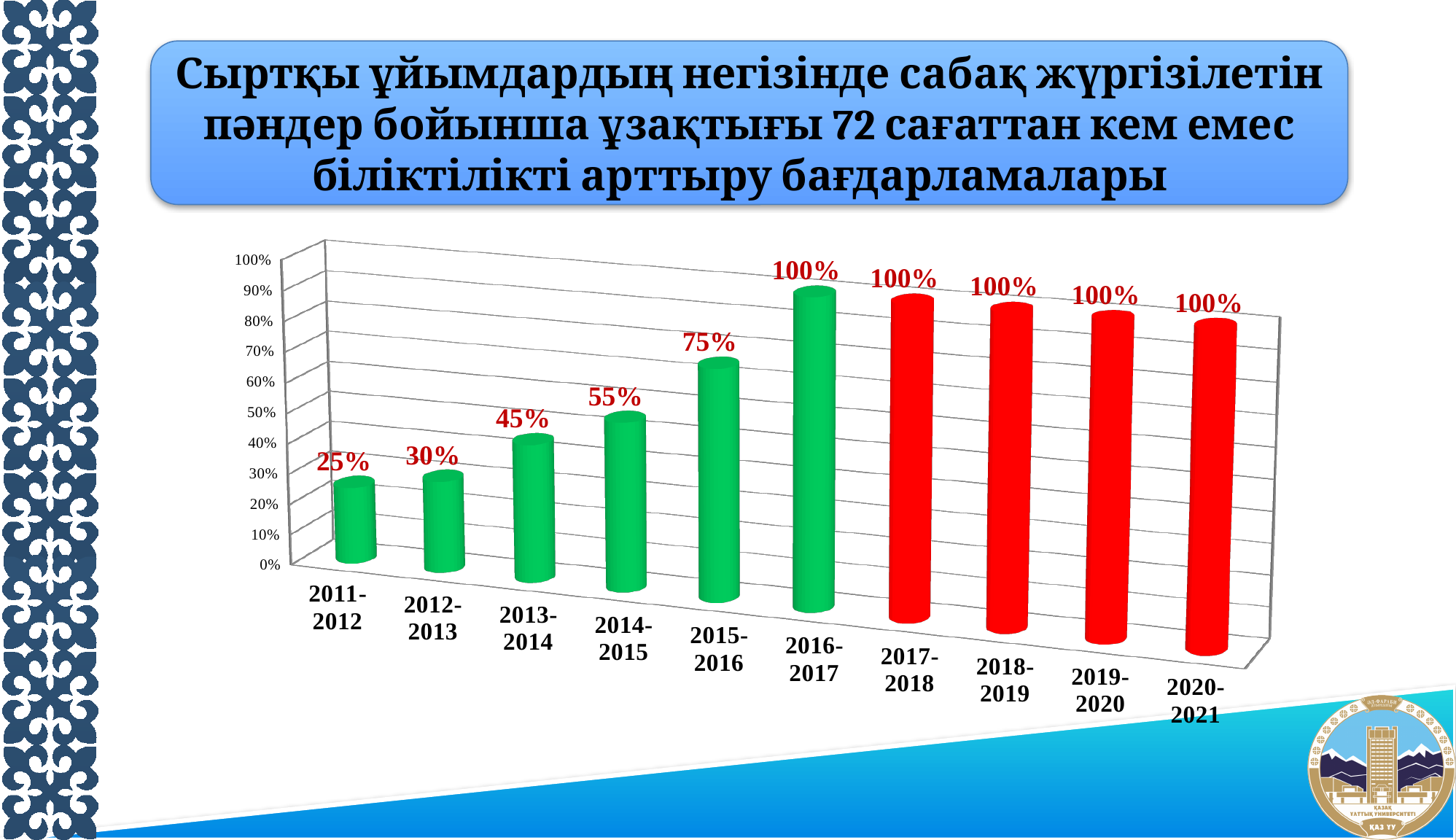
What is the difference between the values for 2016-2017 and 2011-2012? 75% What colour are the bars for 2017-2018 through 2020-2021? red What is the value for 2011-2012? 25% Which category has the lowest value? 2011-2012 What is the difference between the values for 2015-2016 and 2014-2015? 20% Which is larger, the value for 2012-2013 or the value for 2013-2014? 2013-2014 What is the value for 2015-2016? 75% What is the value for 2013-2014? 45% What kind of chart is shown on the slide? bar chart Do the values rise or fall from 2011-2012 to 2016-2017? rise What is the value for 2018-2019? 100% How many categories are shown on the x axis? 10